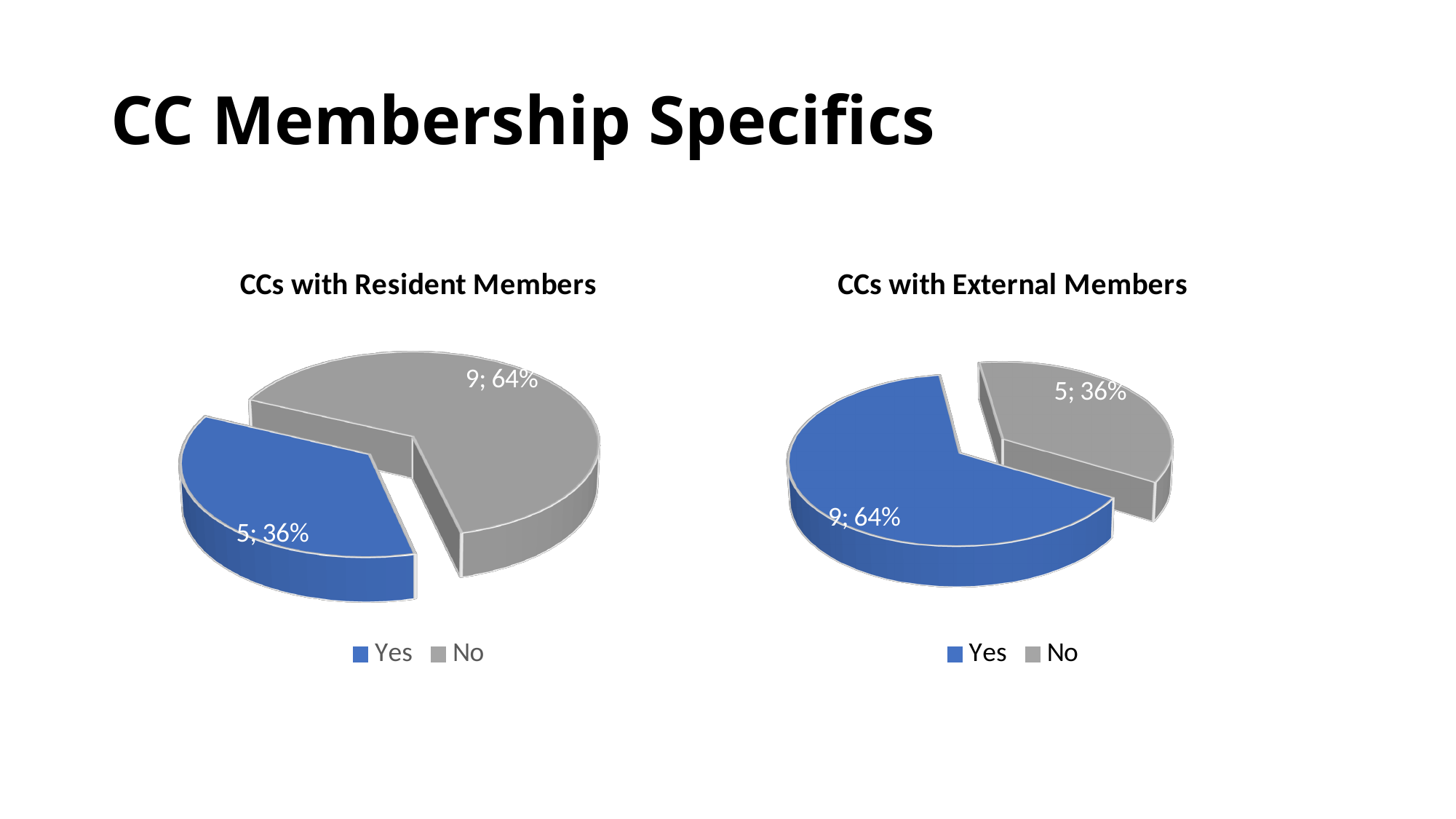
In the 'CCs with Resident Members' chart, what share of the pie is the No slice? 64% In the 'CCs with Resident Members' chart, what is the value for No? 9 In the 'CCs with Resident Members' chart, what is the value for Yes? 5 In the 'CCs with External Members' chart, which is larger, Yes or No? Yes In the 'CCs with External Members' chart, what is the value for Yes? 9 In the 'CCs with External Members' chart, which category is the smallest? No How many entries does the legend of the 'CCs with External Members' chart list? 2 In the 'CCs with Resident Members' chart, what is the difference between the No and Yes values? 4 In the 'CCs with Resident Members' chart, which category is the largest? No What kind of chart is 'CCs with Resident Members'? Pie chart In the 'CCs with External Members' chart, what is the value for No? 5 In the 'CCs with External Members' chart, what share of the pie is the Yes slice? 64%